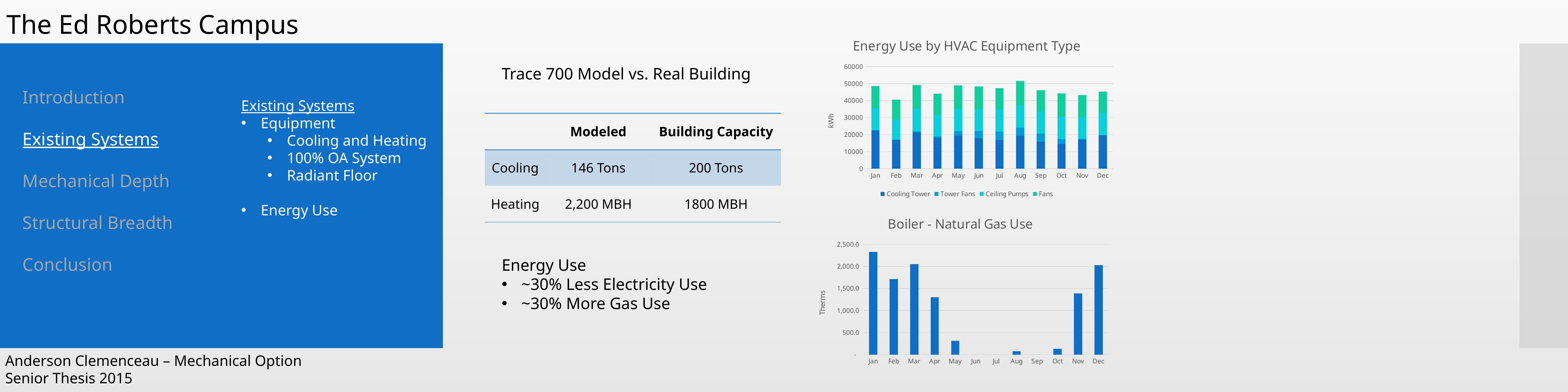
In the 'Energy Use by HVAC Equipment Type' chart, which month has the lowest total energy use? Feb In the 'Energy Use by HVAC Equipment Type' chart, which month has the highest total energy use? Aug In the 'Boiler - Natural Gas Use' chart, which is larger, the value for Feb or the value for Apr? Feb In the 'Boiler - Natural Gas Use' chart, which month has the highest natural gas use? Jan How many months are shown on the x axis of the 'Energy Use by HVAC Equipment Type' chart? 12 In the 'Boiler - Natural Gas Use' chart, is the value for Apr greater or less than 1,500.0? less In the 'Boiler - Natural Gas Use' chart, is the value for Jan greater or less than 2,000.0? greater In the 'Energy Use by HVAC Equipment Type' chart, is the total value for Feb greater or less than 50000? less What is the y-axis label of the 'Energy Use by HVAC Equipment Type' chart? kWh What kind of chart is 'Energy Use by HVAC Equipment Type'? Stacked bar chart How many series does the legend of the 'Energy Use by HVAC Equipment Type' chart list? 4